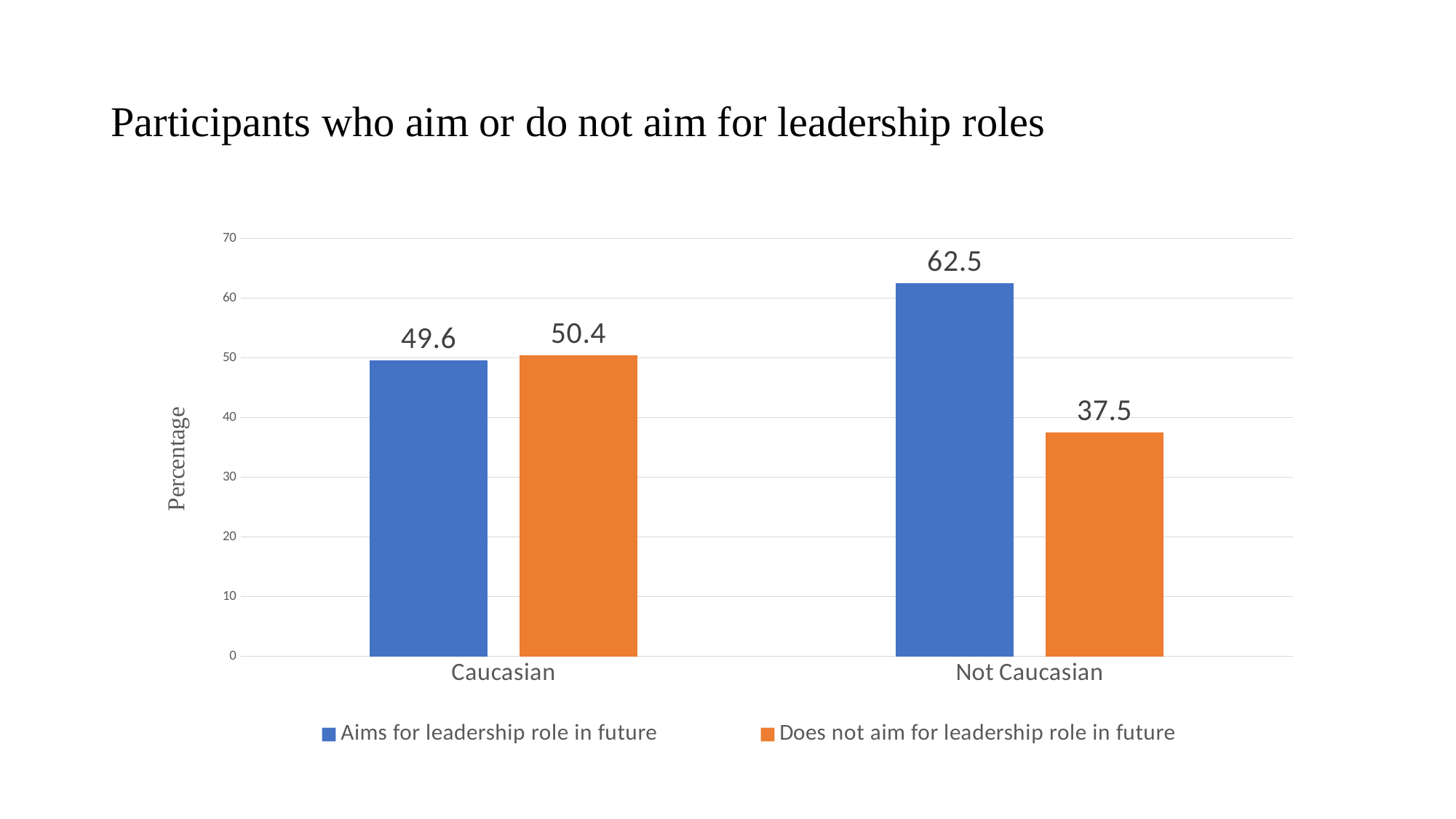
What kind of chart is shown on the slide? Bar chart What is the difference between the 'Aims for leadership role in future' and 'Does not aim for leadership role in future' values in the Not Caucasian category? 25 Which bar has the highest value on the chart? Aims for leadership role in future, Not Caucasian What is the value for 'Does not aim for leadership role in future' in the Not Caucasian category? 37.5 What is the value for 'Aims for leadership role in future' in the Caucasian category? 49.6 What is the label of the vertical axis? Percentage How many categories are shown on the x axis? 2 How many series does the legend list? 2 In the Caucasian category, which is larger: 'Aims for leadership role in future' or 'Does not aim for leadership role in future'? Does not aim for leadership role in future What is the value for 'Does not aim for leadership role in future' in the Caucasian category? 50.4 What is the value for 'Aims for leadership role in future' in the Not Caucasian category? 62.5 Which bar has the lowest value on the chart? Does not aim for leadership role in future, Not Caucasian